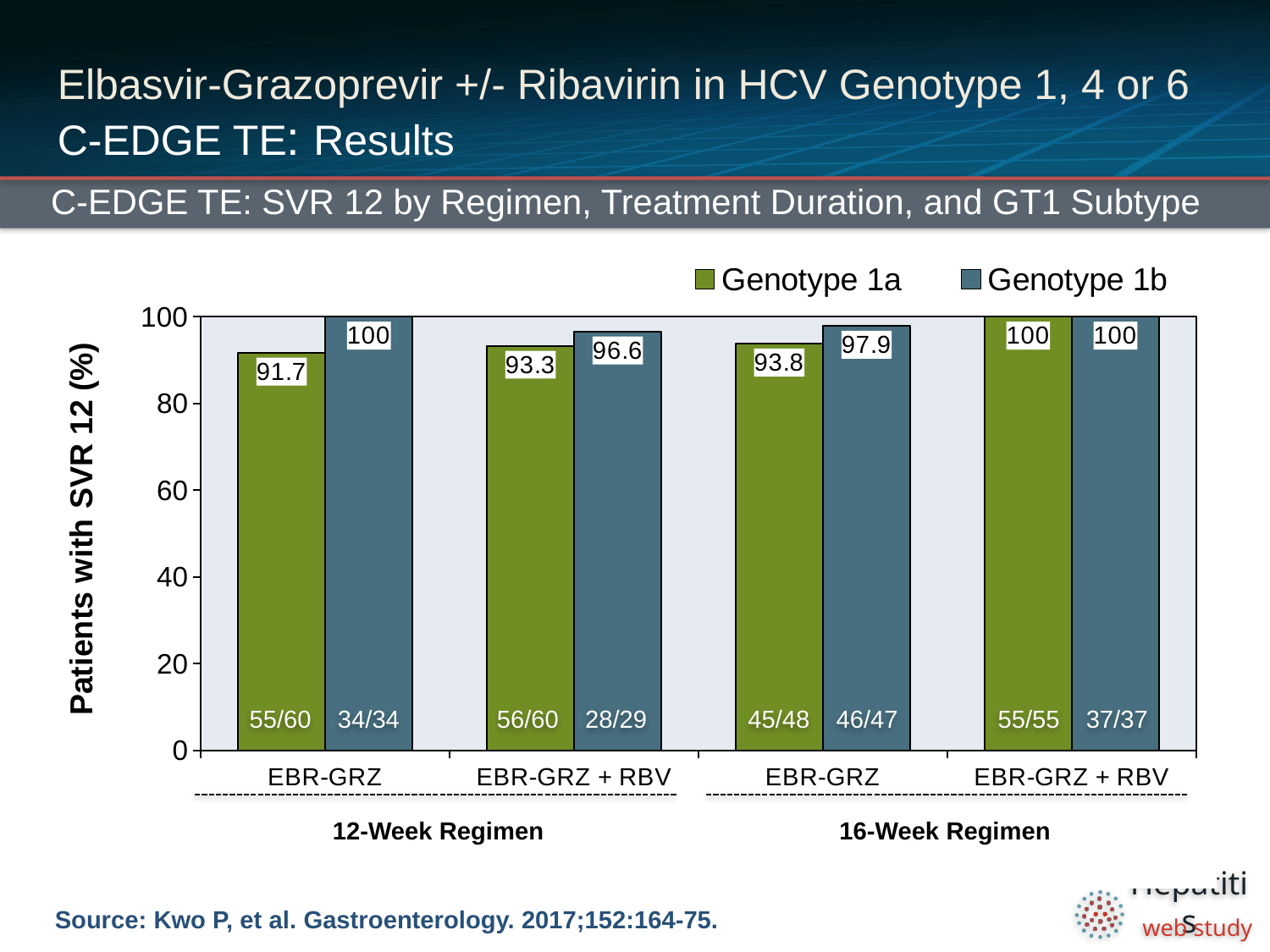
What is the SVR 12 rate for Genotype 1a patients on the 12-week EBR-GRZ regimen? 91.7 What is the SVR 12 rate for Genotype 1b patients on the 12-week EBR-GRZ + RBV regimen? 96.6 What is the difference in SVR 12 rate between Genotype 1b and Genotype 1a for the 12-week EBR-GRZ regimen? 8.3 Which is higher for the 12-week EBR-GRZ + RBV regimen: the Genotype 1a or Genotype 1b SVR 12 rate? Genotype 1b Which regimen group has the lowest SVR 12 rate for Genotype 1a? 12-Week EBR-GRZ What type of chart is shown on the slide? Bar chart What is the SVR 12 rate for Genotype 1a patients on the 16-week EBR-GRZ regimen? 93.8 How many patients achieved SVR 12 among Genotype 1b patients on the 16-week EBR-GRZ regimen, as shown on the bar? 46/47 What is the label of the y axis? Patients with SVR 12 (%) What is the difference in SVR 12 rate between Genotype 1b and Genotype 1a for the 16-week EBR-GRZ regimen? 4.1 How many regimen groups are shown along the x axis? 4 How many series does the legend list? 2